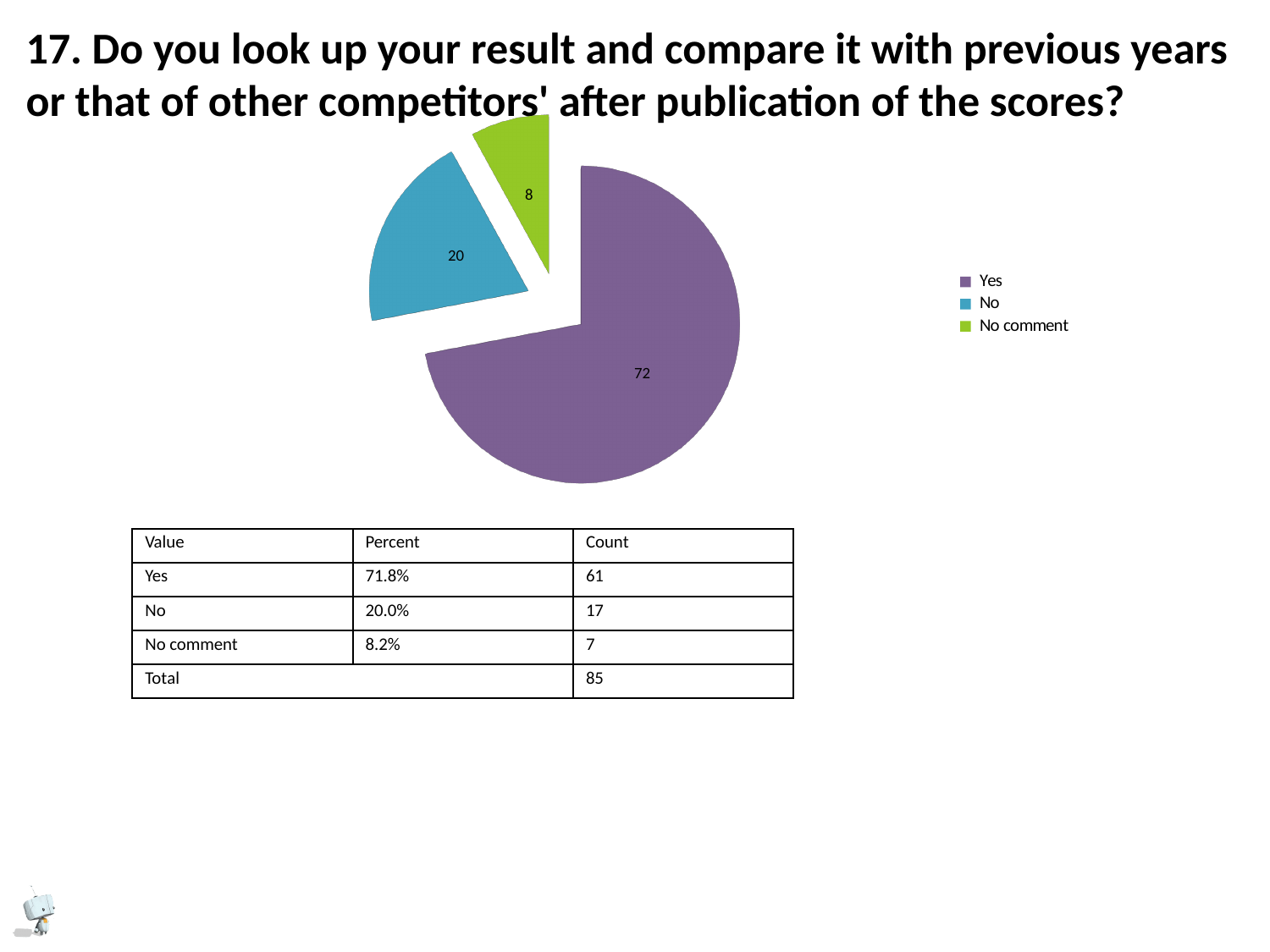
What colour is the Yes slice in the pie chart? purple What is the difference between the labelled values for No and No comment in the pie chart? 12 What value is labelled on the No slice of the pie chart? 20 Which category has the largest slice in the pie chart? Yes Which category has the smallest slice in the pie chart? No comment What type of chart is shown on the slide? pie chart What is the difference between the labelled values for Yes and No in the pie chart? 52 How many slices does the pie chart have? 3 Which slice is larger in the pie chart, No or No comment? No What value is labelled on the Yes slice of the pie chart? 72 How many entries does the legend of the pie chart list? 3 What value is labelled on the No comment slice of the pie chart? 8